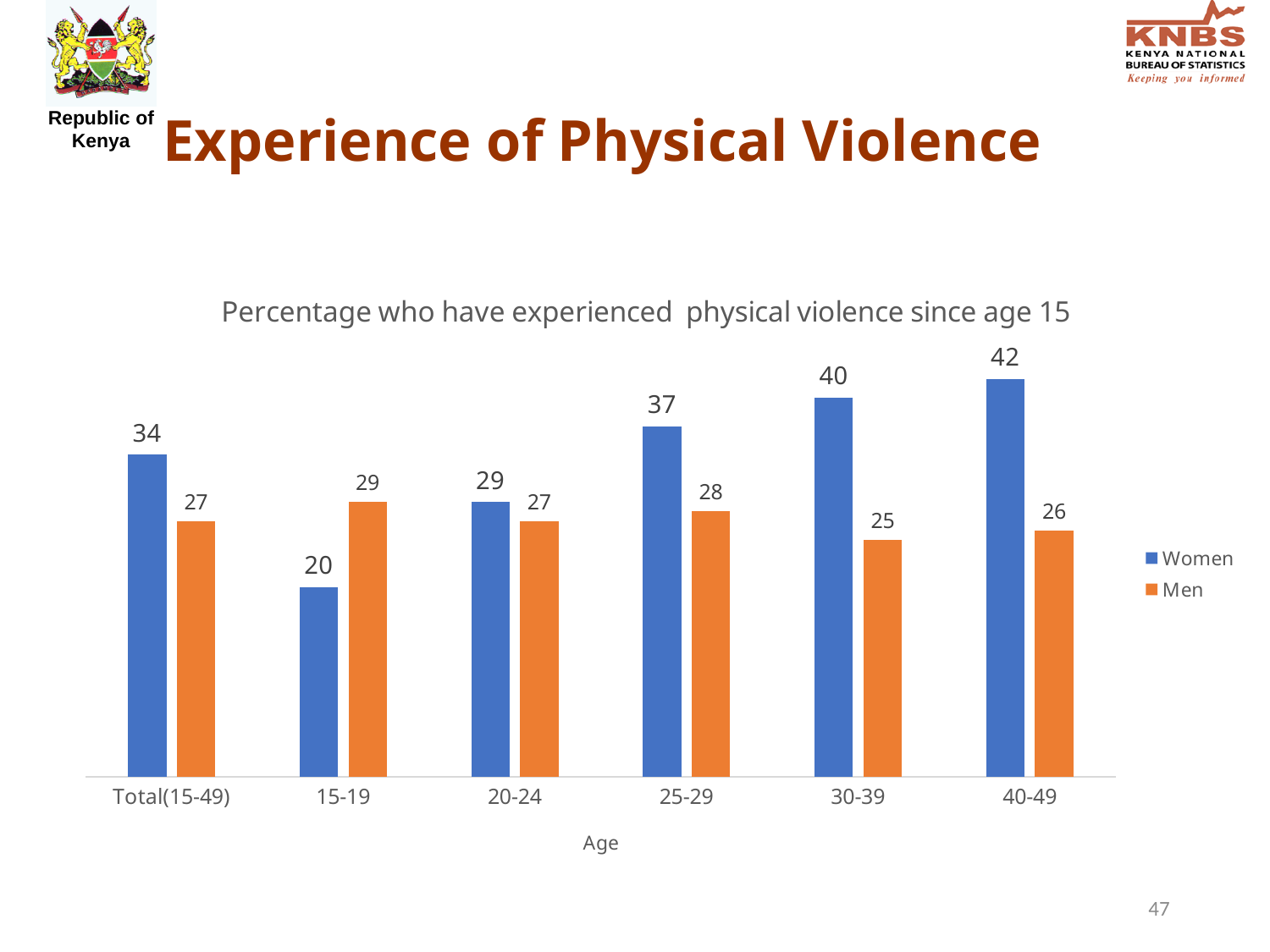
In the 15-19 age group, which is larger, the value for women or for men? Men What is the difference between the women and men values for the 30-39 age group? 15 What kind of chart is shown on the slide? Bar chart Which age group has the lowest value for women? 15-19 Which age group has the lowest value for men? 30-39 How many age categories are shown on the x axis? 6 What is the value for men in the 15-19 age group? 29 What percentage of women aged 40-49 have experienced physical violence since age 15? 42 Which age group has the highest value for women? 40-49 What is the value for women in the Total(15-49) category? 34 Do the values for women rise or fall from the 15-19 age group to the 40-49 age group? Rise How many series does the legend list? 2